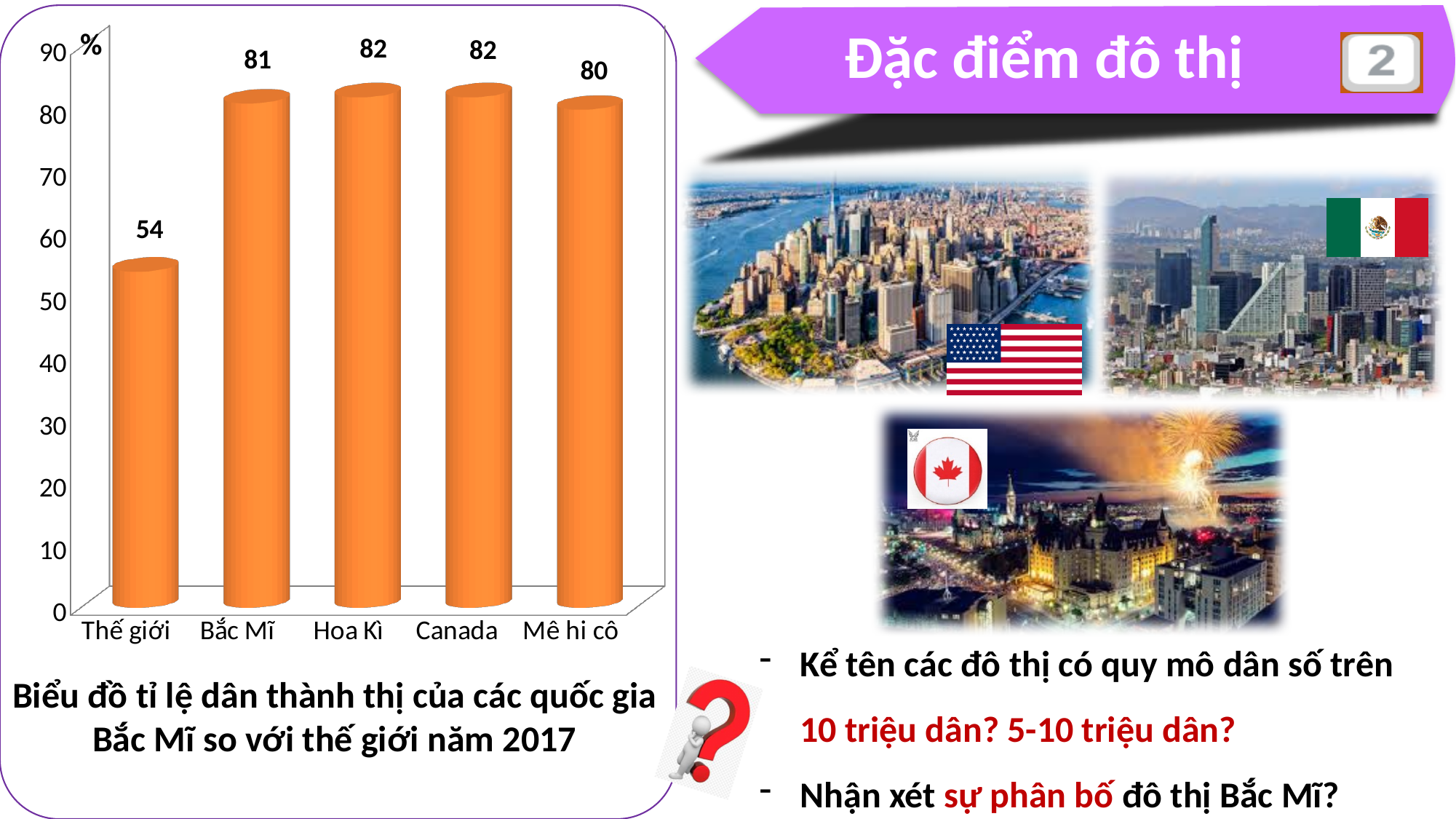
What is the value for Bắc Mĩ? 81 What is the value for Canada? 82 Which is larger, the value for Bắc Mĩ or the value for Thế giới? Bắc Mĩ What unit is shown at the top of the vertical axis? % What is the value for Mê hi cô? 80 Which category has the lowest value? Thế giới What is the value for Thế giới? 54 What kind of chart is shown on the slide? bar chart How many categories are shown on the x axis? 5 Is the value for Thế giới greater or less than 60? less What is the difference between the values for Hoa Kì and Thế giới? 28 What is the difference between the values for Bắc Mĩ and Mê hi cô? 1